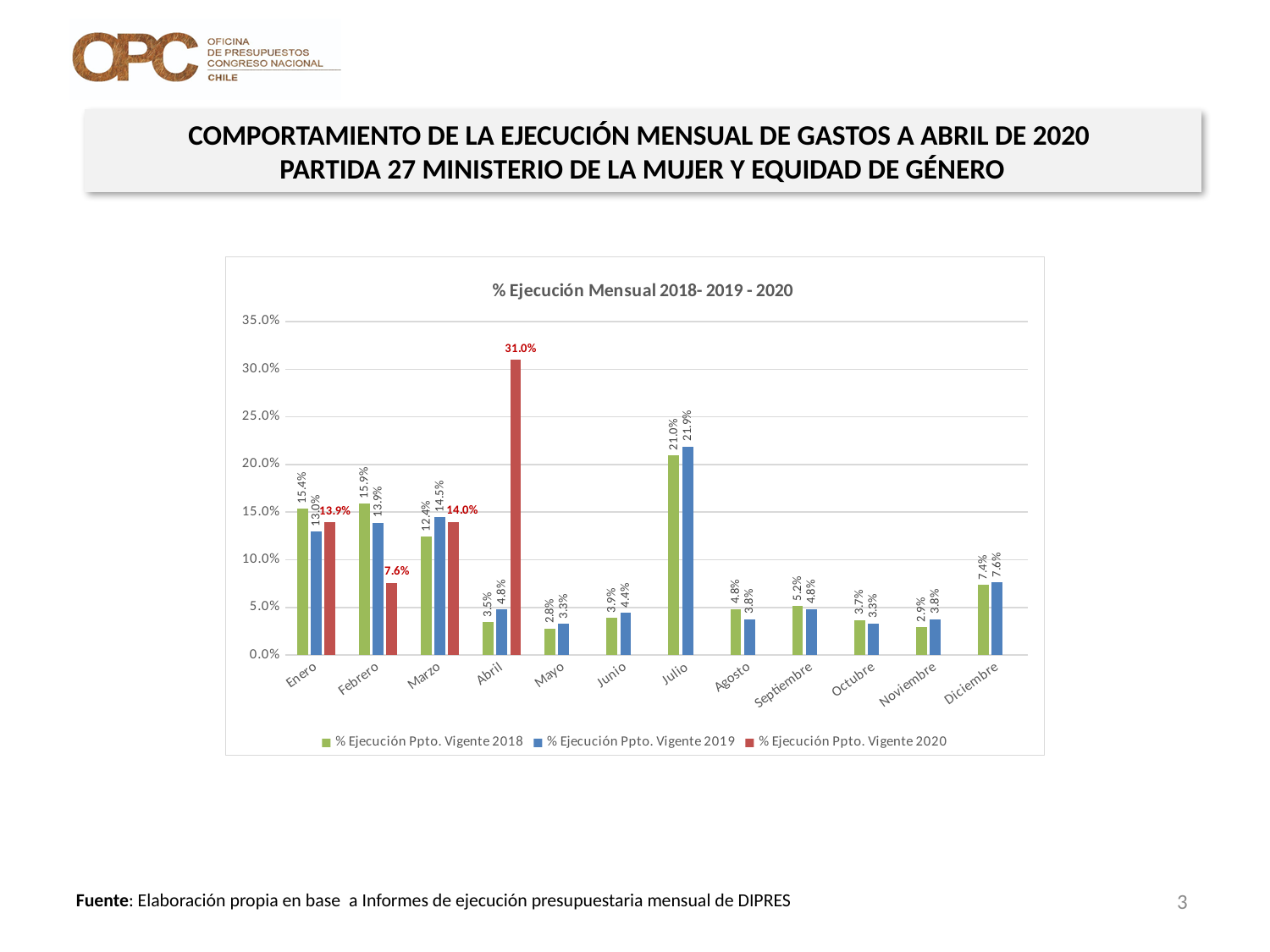
In Enero, which is larger: the 2018 value or the 2019 value? 2018 Which month has the highest value for % Ejecución Ppto. Vigente 2019? Julio How many series does the legend list? 3 What is the value for % Ejecución Ppto. Vigente 2020 in Abril? 31.0% What kind of chart is shown on the slide? Bar chart What is the value for % Ejecución Ppto. Vigente 2018 in Julio? 21.0% Is the value for % Ejecución Ppto. Vigente 2020 in Abril greater or less than 30.0%? greater Which month has the lowest value for % Ejecución Ppto. Vigente 2018? Mayo How many months are shown on the x axis? 12 What is the value for % Ejecución Ppto. Vigente 2020 in Febrero? 7.6% What is the difference between the 2020 and 2019 values in Abril? 26.2% What is the value for % Ejecución Ppto. Vigente 2019 in Marzo? 14.5%